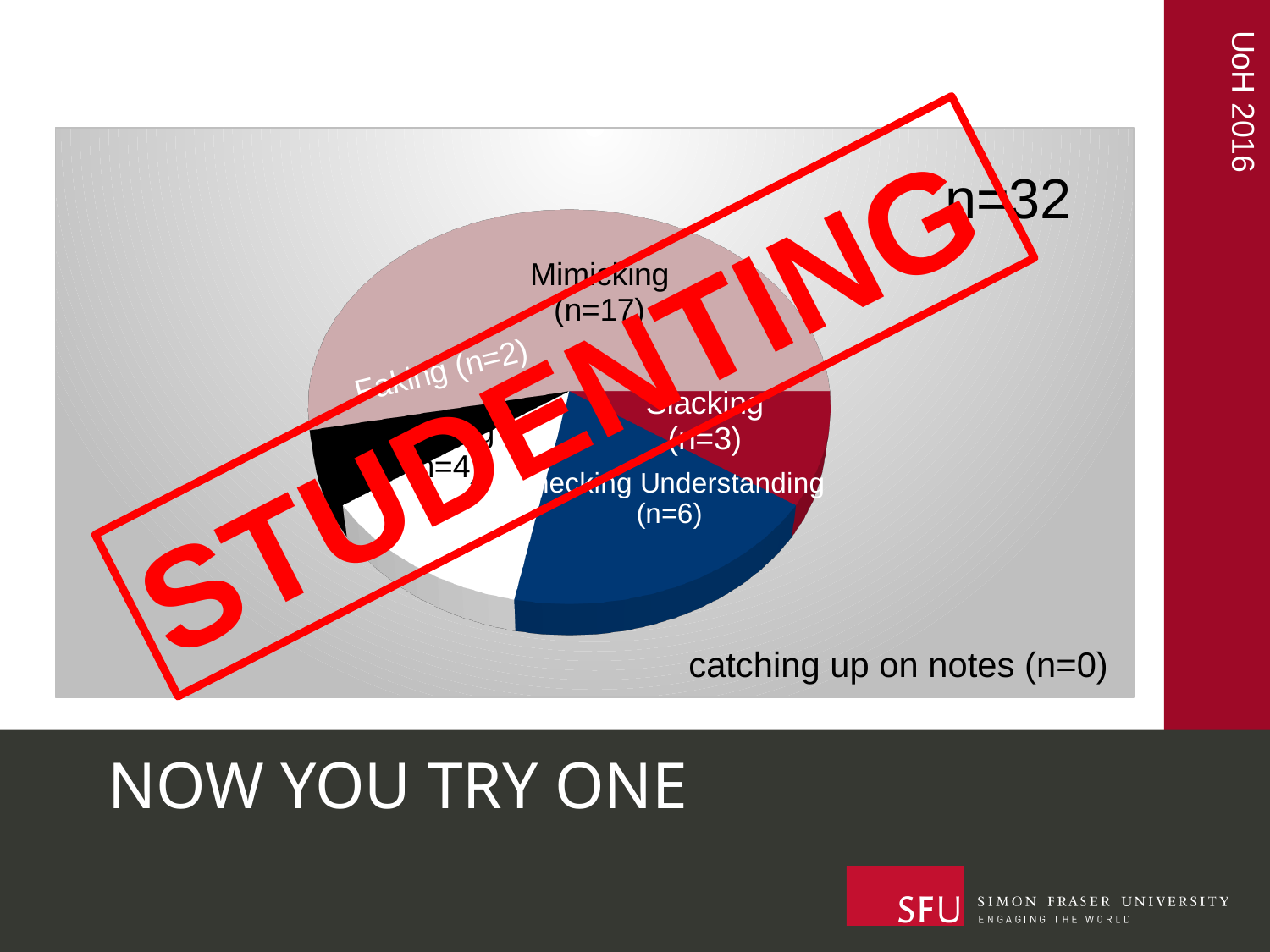
What is the n value shown for catching up on notes? 0 Which is larger, the n value for Checking Understanding or for Slacking? Checking Understanding What total sample size is printed in the top right of the chart? n=32 Which category has the largest slice of the pie chart? Mimicking What kind of chart is shown on the slide? pie chart How many students are in the Mimicking slice of the pie chart? 17 What is the n value for Checking Understanding in the pie chart? 6 Which category has the smallest n value on the pie chart? catching up on notes What word is stamped in red across the pie chart? STUDENTING How many categories are labelled on the pie chart? 6 What is the difference between the n values for Mimicking and Checking Understanding? 11 Which is larger, the n value for Mimicking or for Checking Understanding? Mimicking